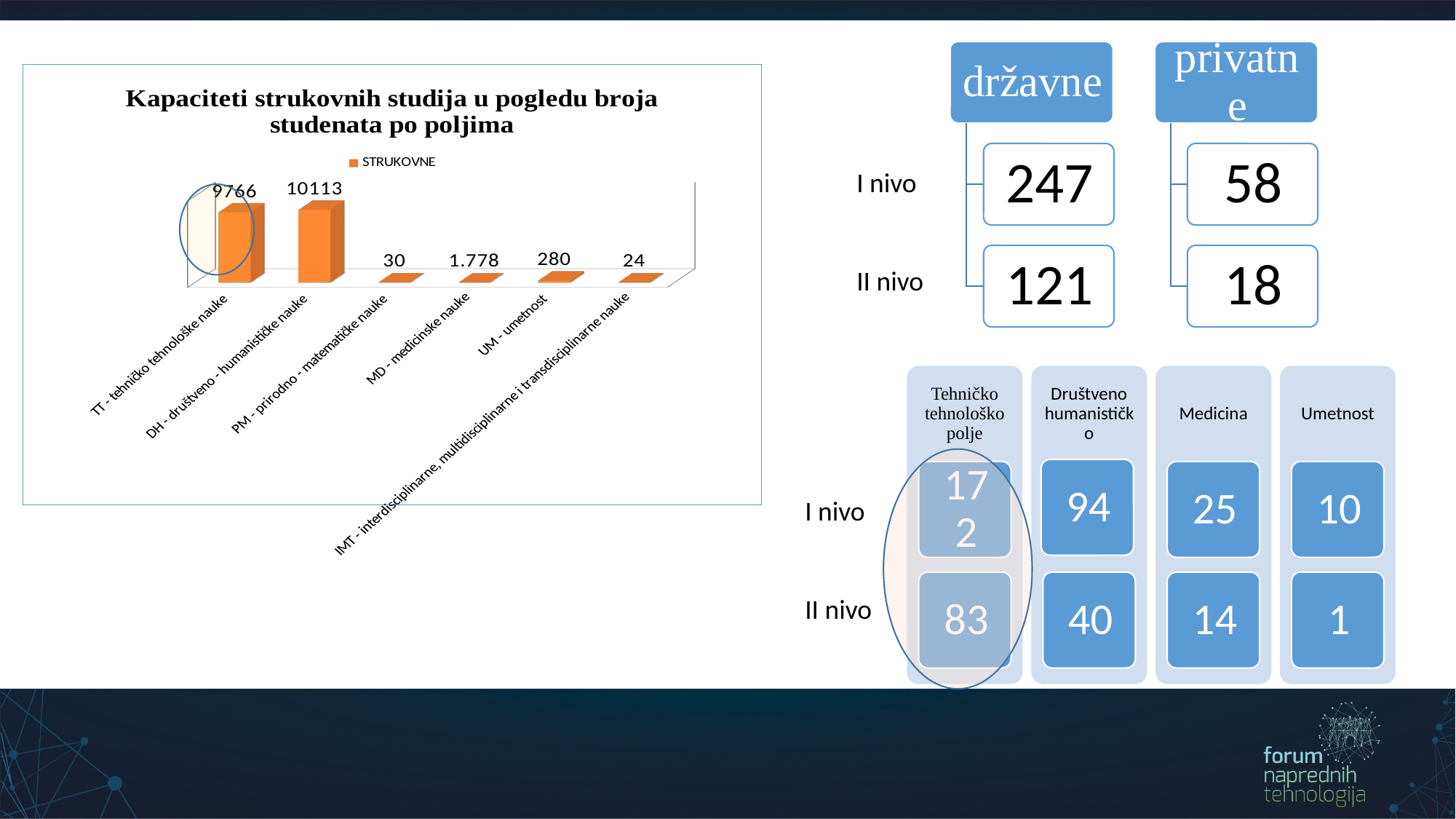
What is the value for DH - društveno - humanističke nauke? 10113 What is the value for PM - prirodno - matematičke nauke? 30 What is the difference between the values for DH - društveno - humanističke nauke and TT - tehničko tehnološke nauke? 347 What is the value for UM - umetnost? 280 What kind of chart is shown on the slide? Bar chart Which category has the lowest value? IMT - interdisciplinarne, multidisciplinarne i transdisciplinarne nauke Which category has the highest value? DH - društveno - humanističke nauke What is the value for MD - medicinske nauke? 1.778 How many categories are shown on the x axis of the chart? 6 What is the value for TT - tehničko tehnološke nauke? 9766 Which is larger, the value for UM - umetnost or the value for MD - medicinske nauke? UM - umetnost What is the difference between the values for UM - umetnost and PM - prirodno - matematičke nauke? 250